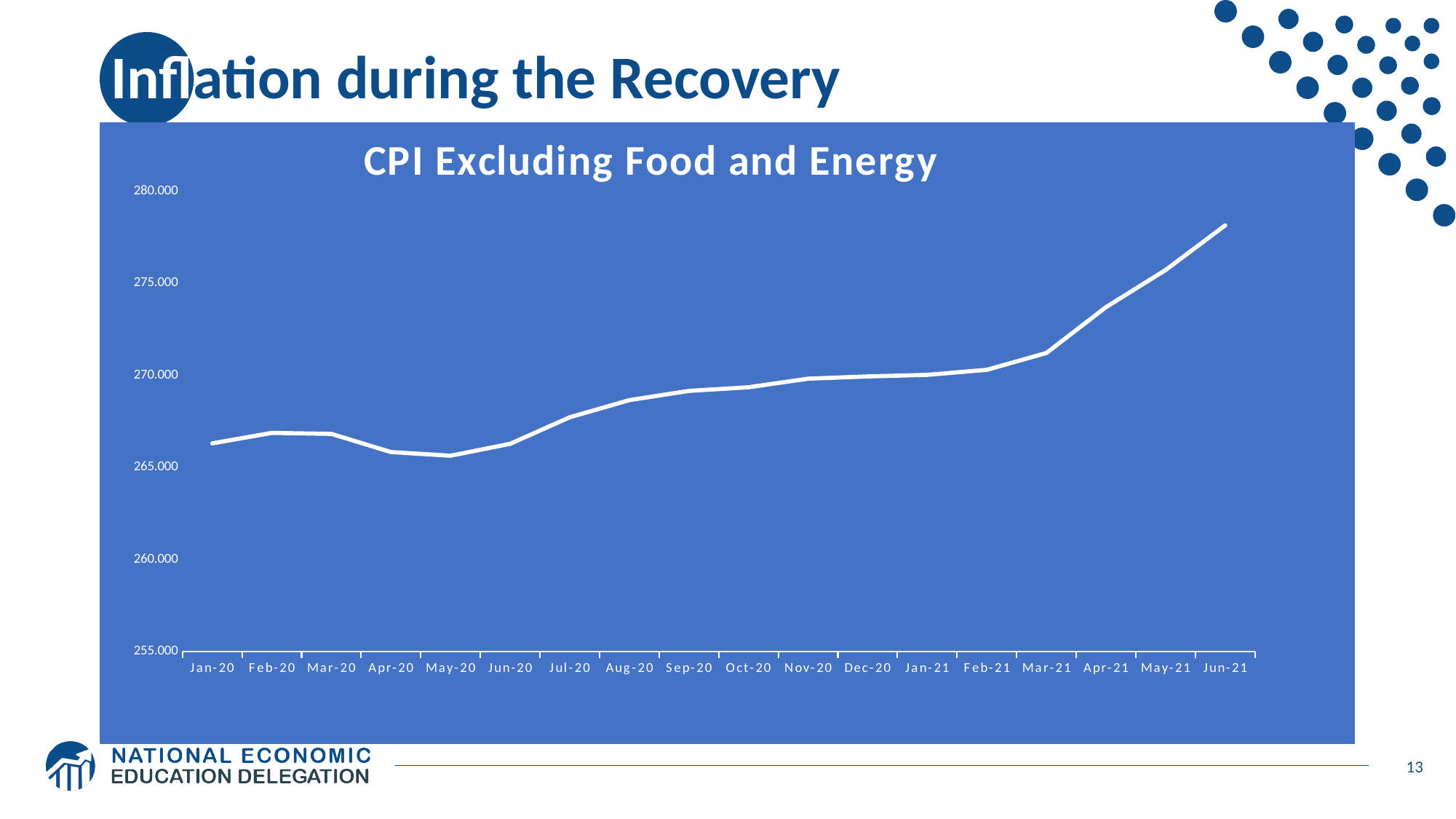
Which month has the highest value on the chart? Jun-21 Overall, do the values rise or fall from Jan-20 to Jun-21? rise What is the title of the chart? CPI Excluding Food and Energy What kind of chart is shown on the slide? line chart Is the value for May-20 greater or less than 270.000? less Which is larger, the value for Feb-20 or the value for May-20? Feb-20 Is the value for Apr-21 greater or less than 270.000? greater How many months are plotted along the x axis? 18 Which month has the lowest value on the chart? May-20 Is the value for Jan-20 greater or less than 265.000? greater Which is larger, the value for Jun-21 or the value for Jan-20? Jun-21